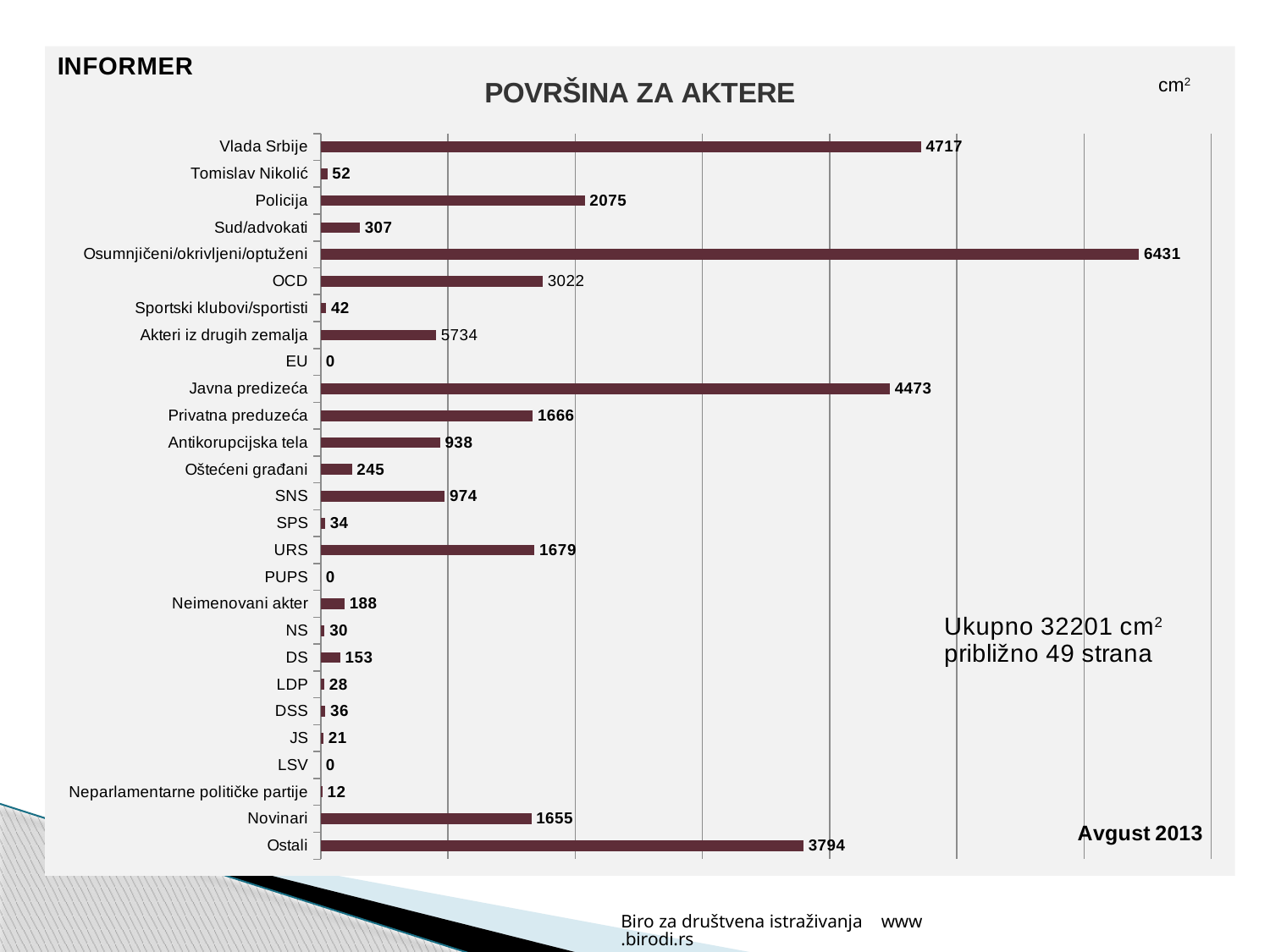
What kind of chart is shown on the slide? Bar chart Which category has the highest value? Osumnjičeni/okrivljeni/optuženi What is the value for SNS? 974 What is the value for Policija? 2075 Which is larger, the value for OCD or the value for Ostali? Ostali What is the title of the chart? POVRŠINA ZA AKTERE How many categories have a value of 0? 3 What is the value for Novinari? 1655 What is the value for Vlada Srbije? 4717 What is the difference between the values for Vlada Srbije and Javna predizeća? 244 How many categories are shown in the chart? 27 What is the difference between the values for Policija and Novinari? 420